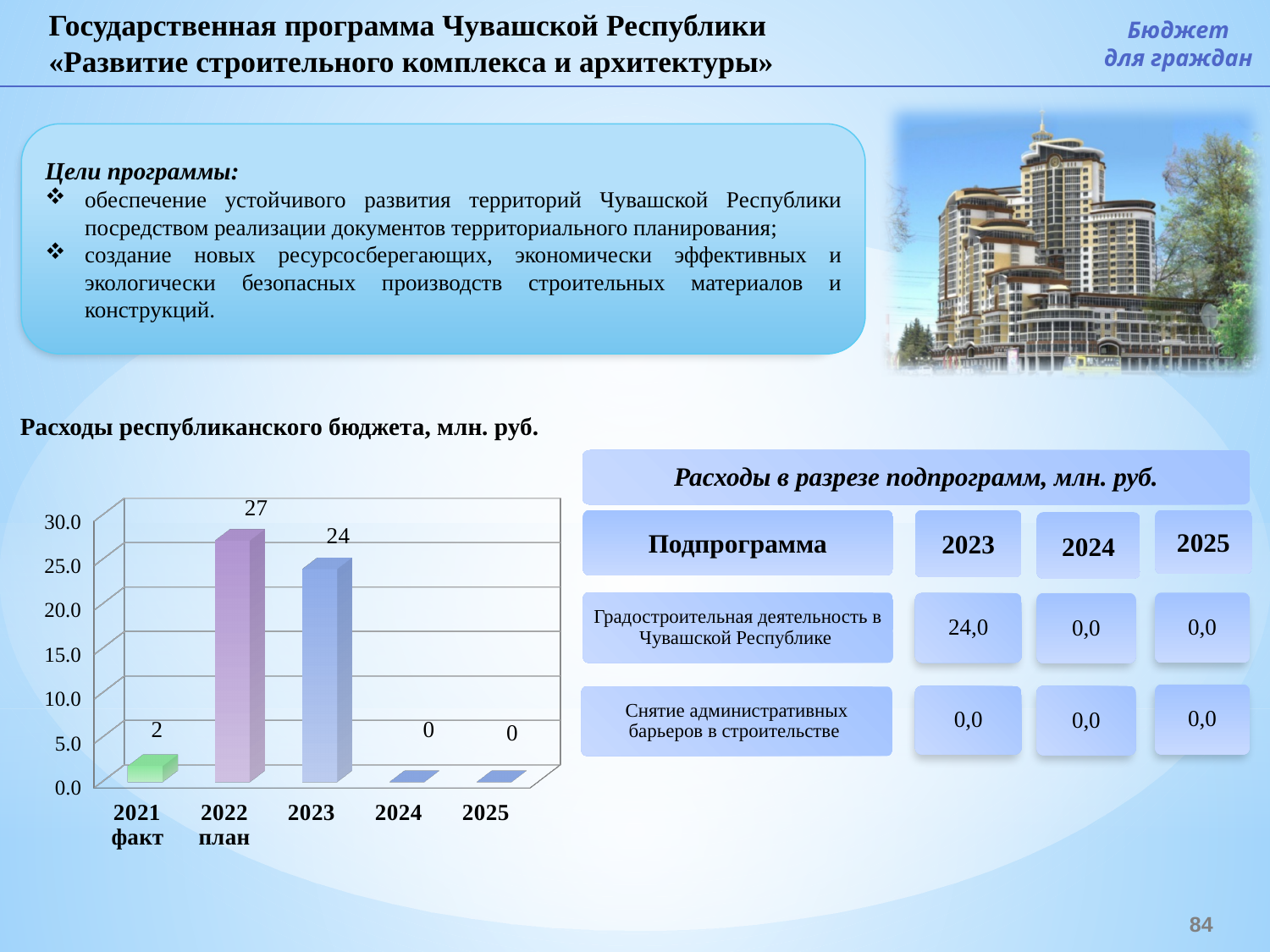
What is the difference between the values for 2022 план and 2023? 3 What is the title above the chart? Расходы республиканского бюджета, млн. руб. What kind of chart is shown on the slide? bar chart What is the value for 2025 in the chart? 0 Which is larger, the value for 2021 факт or the value for 2023? 2023 What is the difference between the values for 2023 and 2021 факт? 22 What is the value for 2021 факт in the chart? 2 What is the value for 2023 in the chart? 24 Is the value for 2022 план greater or less than 25.0? greater What is the value for 2022 план in the chart? 27 How many categories are shown on the x axis of the chart? 5 Which year has the highest value in the chart? 2022 план